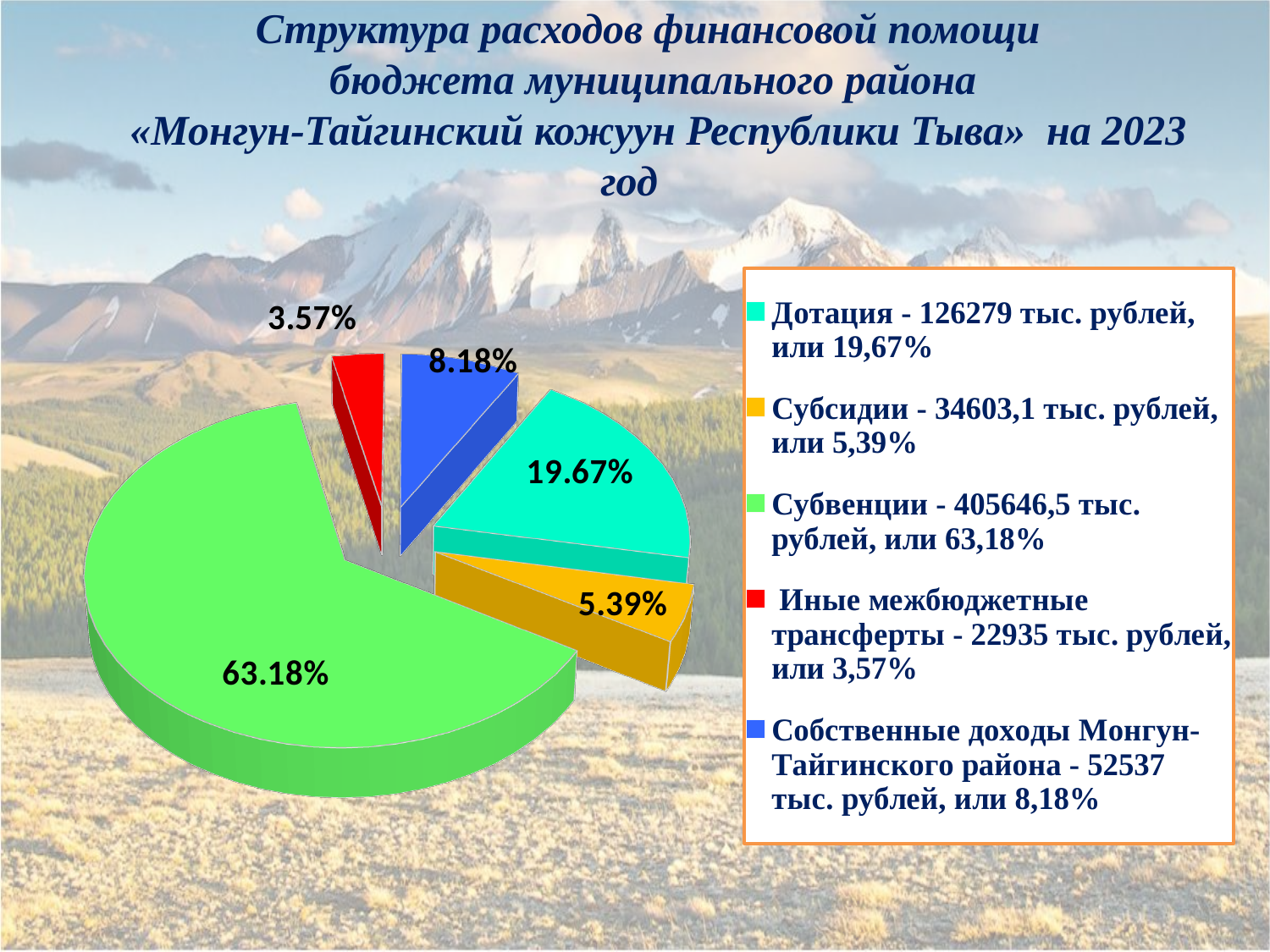
How many entries does the legend list? 5 Which category has the smallest slice of the pie? Иные межбюджетные трансферты What percentage is shown for Дотация? 19.67% What share of the pie does Субвенции account for? 63.18% What percentage is shown for Субсидии? 5.39% Which is larger, the share for Собственные доходы Монгун-Тайгинского района or the share for Субсидии? Собственные доходы Монгун-Тайгинского района Which category has the largest slice of the pie? Субвенции What kind of chart is shown on the slide? Pie chart What is the difference in percentage points between Субвенции and Дотация? 43.51 What percentage is shown for Иные межбюджетные трансферты? 3.57% How many slices does the pie chart have? 5 According to the legend, what amount in thousand rubles corresponds to Субвенции? 405646,5 тыс. рублей